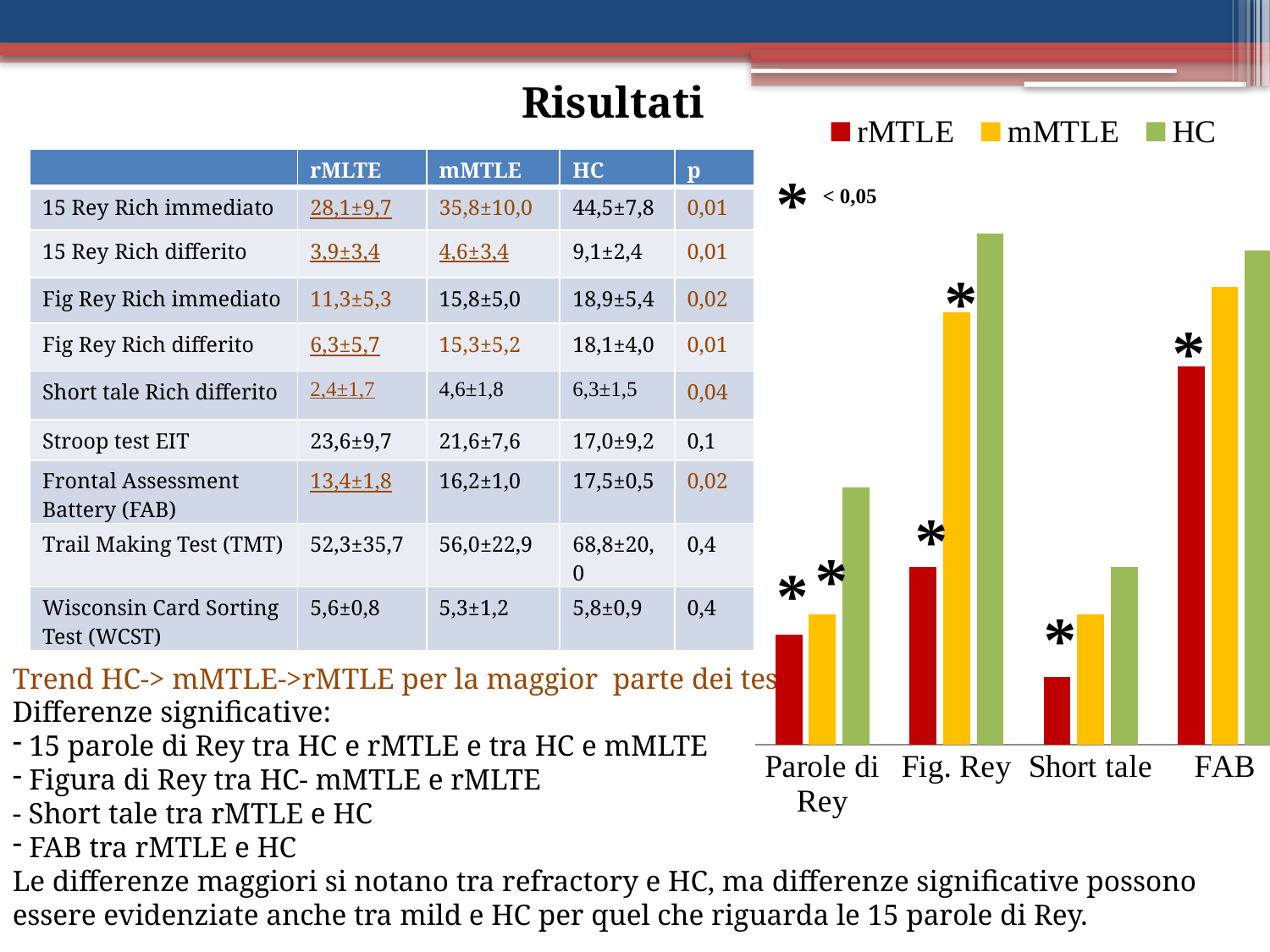
Which series in the bar chart is shown in green? HC In the Parole di Rey group of the bar chart, is the HC bar taller or shorter than the rMTLE bar? taller Which series in the bar chart is shown in red? rMTLE In the FAB group of the bar chart, which series has the shortest bar? rMTLE What kind of chart is shown on the right of the slide? bar chart How many series does the legend of the bar chart list? 3 How many categories are shown on the x axis of the bar chart? 4 In the FAB group of the bar chart, which series has the tallest bar? HC In the Fig. Rey group of the bar chart, which series has the tallest bar? HC In the Short tale group of the bar chart, which series has the shortest bar? rMTLE In the bar chart, which category has the tallest rMTLE bar? FAB In the bar chart, which category has the shortest HC bar? Short tale